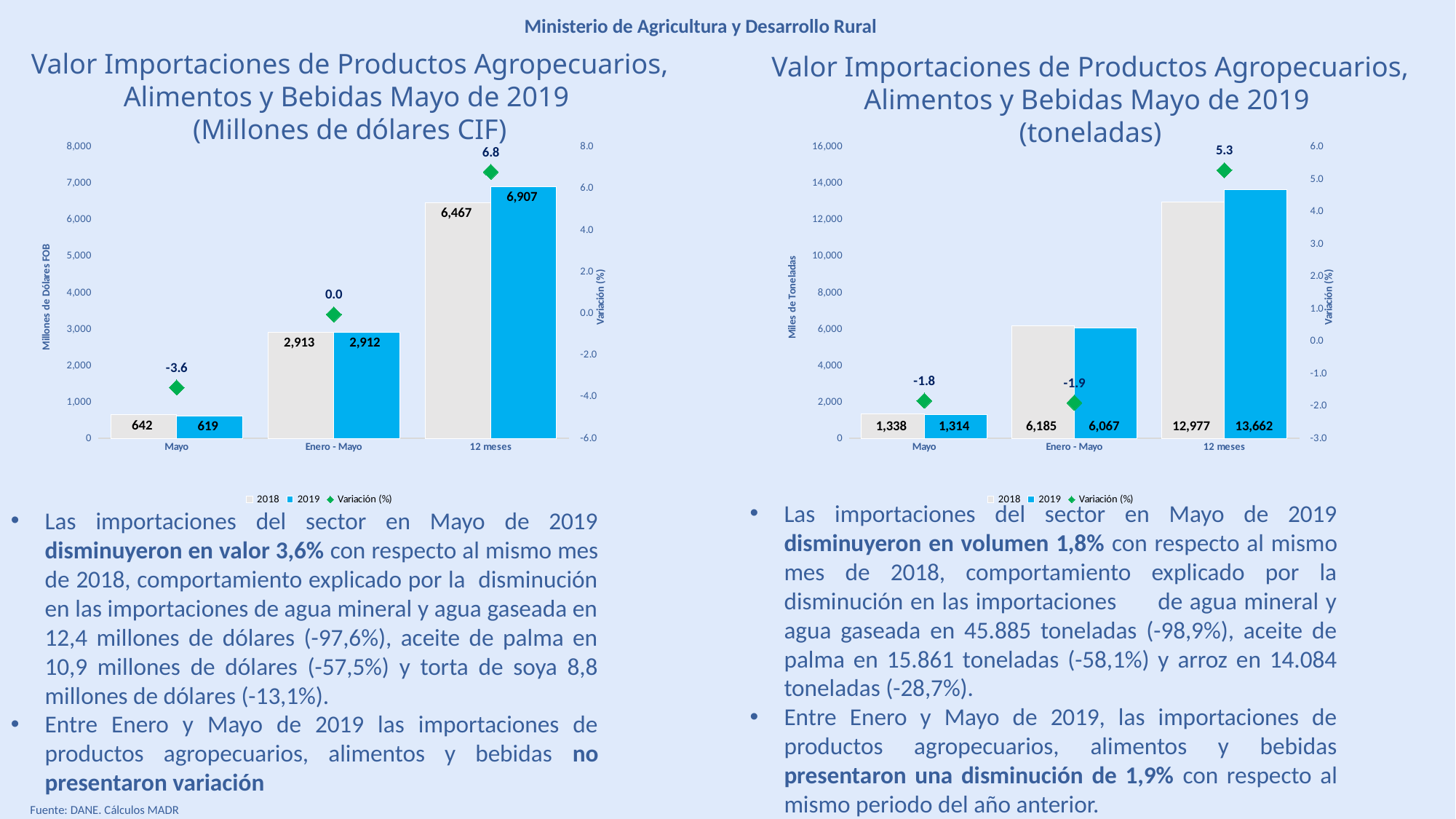
In the left chart (Millones de dólares CIF), which category has the lowest 2018 value? Mayo In the right chart (toneladas), what is the difference between the 2019 and 2018 values for Mayo? 24 In the right chart (toneladas), what is the 2019 value for Enero - Mayo? 6,067 In the right chart (toneladas), which is larger for 12 meses, the 2018 value or the 2019 value? 2019 In the right chart (toneladas), what is the Variación (%) for 12 meses? 5.3 In the left chart (Millones de dólares CIF), what is the 2018 value for 12 meses? 6,467 In the left chart (Millones de dólares CIF), what is the Variación (%) for Enero - Mayo? 0.0 In the left chart (Millones de dólares CIF), what is the difference between the 2019 and 2018 values for 12 meses? 440 How many categories are shown on the x axis of the left chart (Millones de dólares CIF)? 3 In the left chart (Millones de dólares CIF), what is the 2019 value for Mayo? 619 What type of chart is the right chart (toneladas)? Bar chart with a line/marker series In the right chart (toneladas), how many series does the legend list? 3